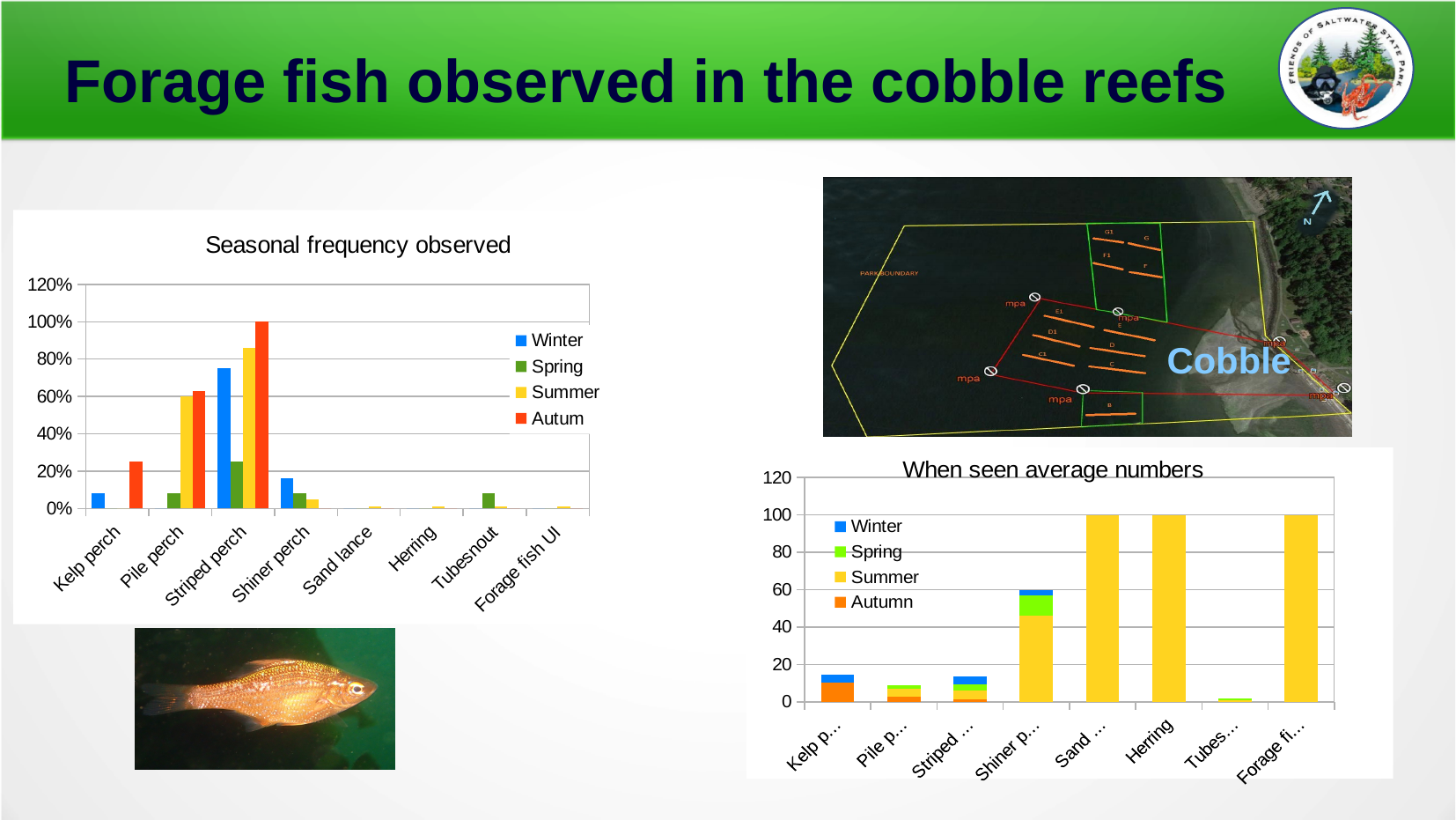
In the 'Seasonal frequency observed' chart, how many fish categories are shown on the x axis? 8 In the 'When seen average numbers' chart, how many series does the legend list? 4 In the 'Seasonal frequency observed' chart, is the Winter value for Striped perch greater or less than 60%? greater In the 'Seasonal frequency observed' chart, which category has the highest bar overall? Striped perch In the 'When seen average numbers' chart, what is the Summer value for Herring? 100 In the 'Seasonal frequency observed' chart, what kind of chart is shown? bar chart In the 'When seen average numbers' chart, what kind of chart is shown? stacked bar chart In the 'When seen average numbers' chart, is the total for Shiner perch greater or less than 40? greater In the 'Seasonal frequency observed' chart, which is larger: the Summer value for Striped perch or the Summer value for Pile perch? Striped perch In the 'Seasonal frequency observed' chart, what is the Autum value for Striped perch? 100% In the 'Seasonal frequency observed' chart, how many series does the legend list? 4 In the 'Seasonal frequency observed' chart, is the Autum value for Kelp perch greater or less than 40%? less